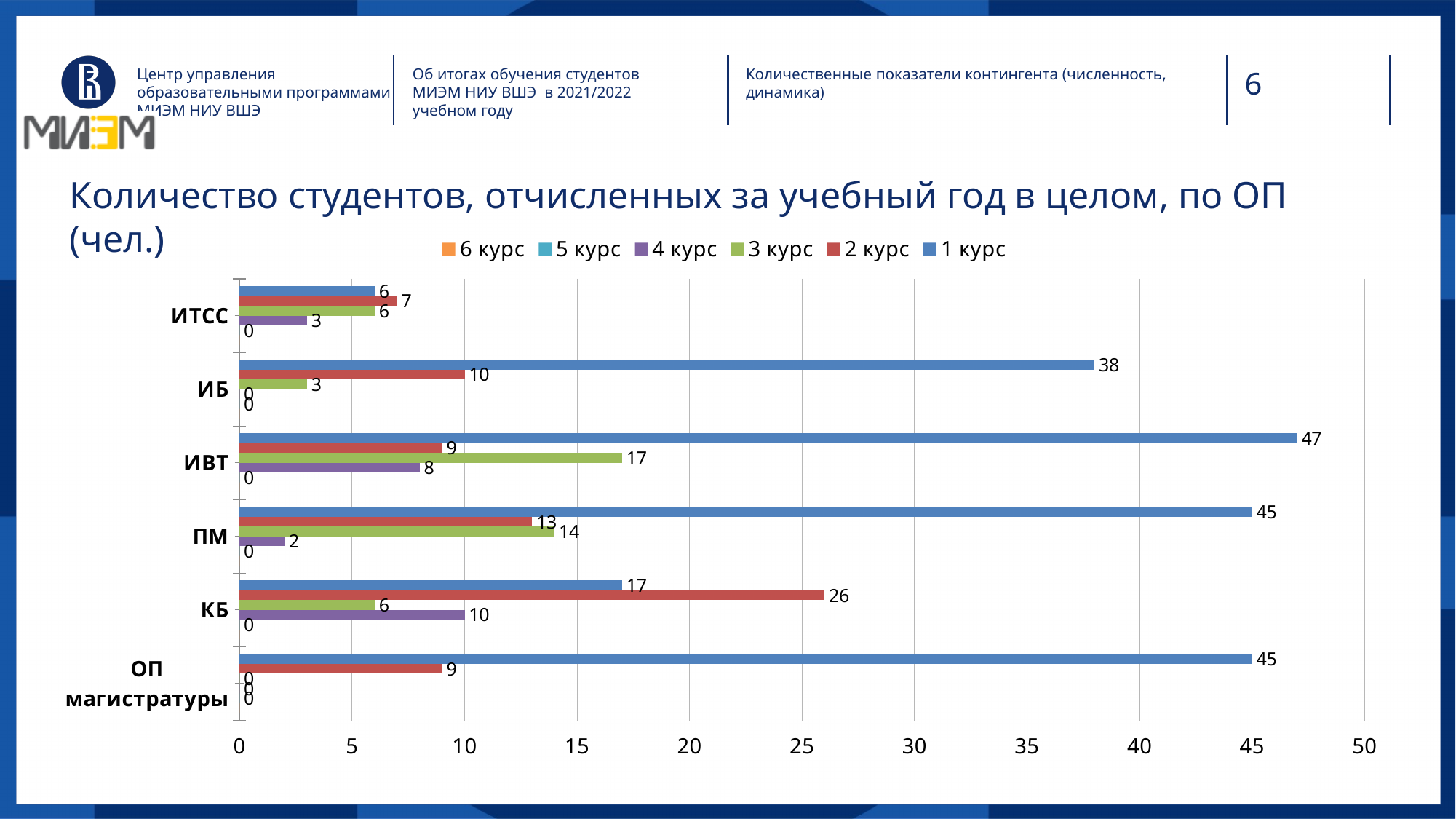
Which category has the highest value for 1 курс? ИВТ What is the value for 3 курс in the ПМ category? 14 What is the difference between the 1 курс values for ИВТ and ИБ? 9 What is the value for 2 курс in the КБ category? 26 What is the title of the chart? Количество студентов, отчисленных за учебный год в целом, по ОП (чел.) What is the value for 1 курс in the ИВТ category? 47 Which category has the lowest value for 1 курс? ИТСС What is the value for 1 курс in the ИБ category? 38 How many series does the legend list? 6 In the КБ category, which is larger: the value for 1 курс or for 2 курс? 2 курс How many educational programmes (categories) are shown on the chart? 6 What type of chart is shown on the slide? Bar chart